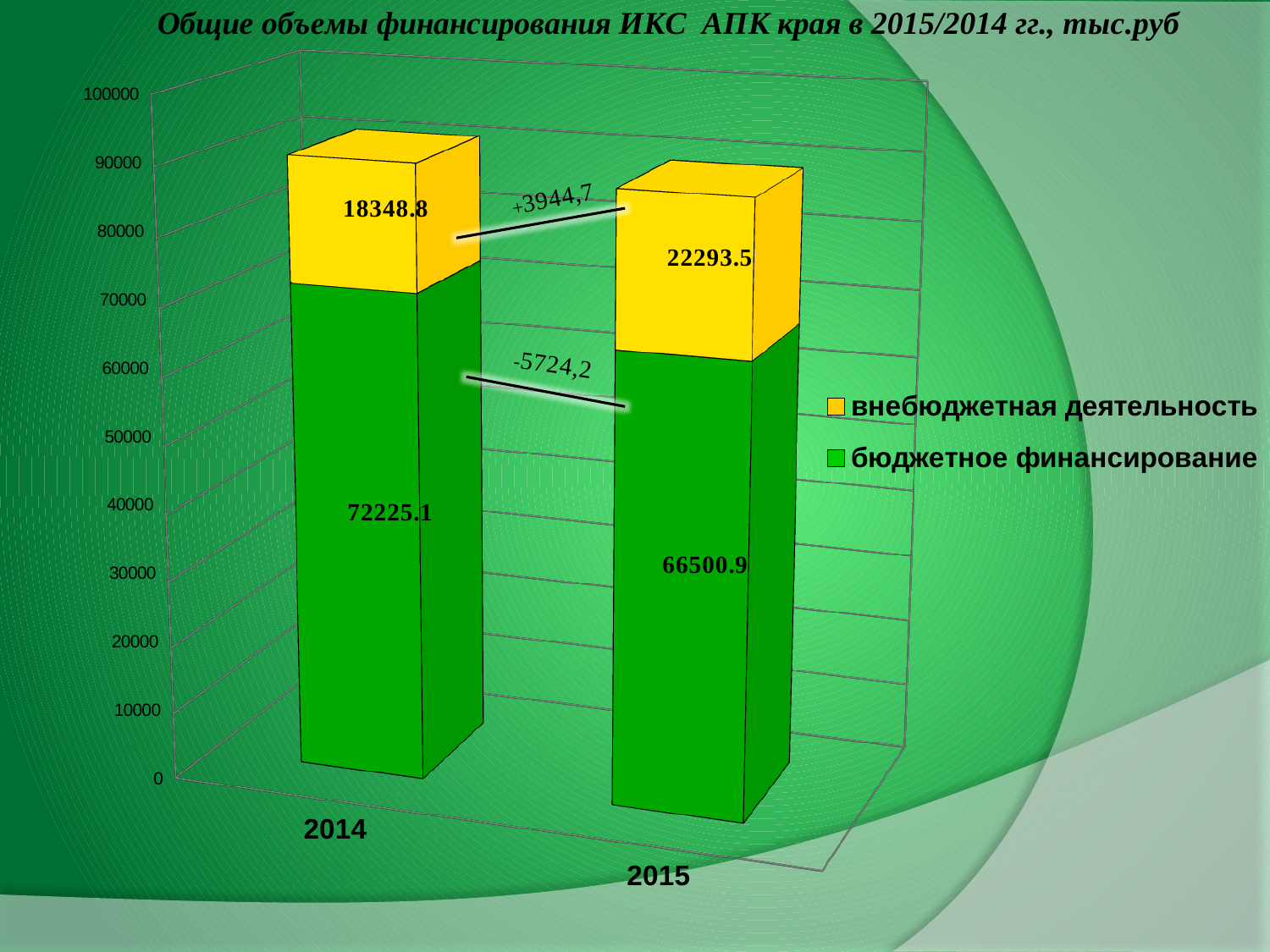
How many series does the legend list? 2 Which year has the higher value for бюджетное финансирование? 2014 Which year has the higher value for внебюджетная деятельность? 2015 What is the value of бюджетное финансирование for 2015? 66500.9 What is the value of внебюджетная деятельность for 2014? 18348.8 By how much did бюджетное финансирование decrease from 2014 to 2015? 5724.2 What is the value of внебюджетная деятельность for 2015? 22293.5 What is the total of the stacked bar for 2015? 88794.4 What is the value of бюджетное финансирование for 2014? 72225.1 What is the total of the stacked bar for 2014? 90573.9 By how much did внебюджетная деятельность increase from 2014 to 2015? 3944.7 What kind of chart is shown on the slide? Stacked bar chart